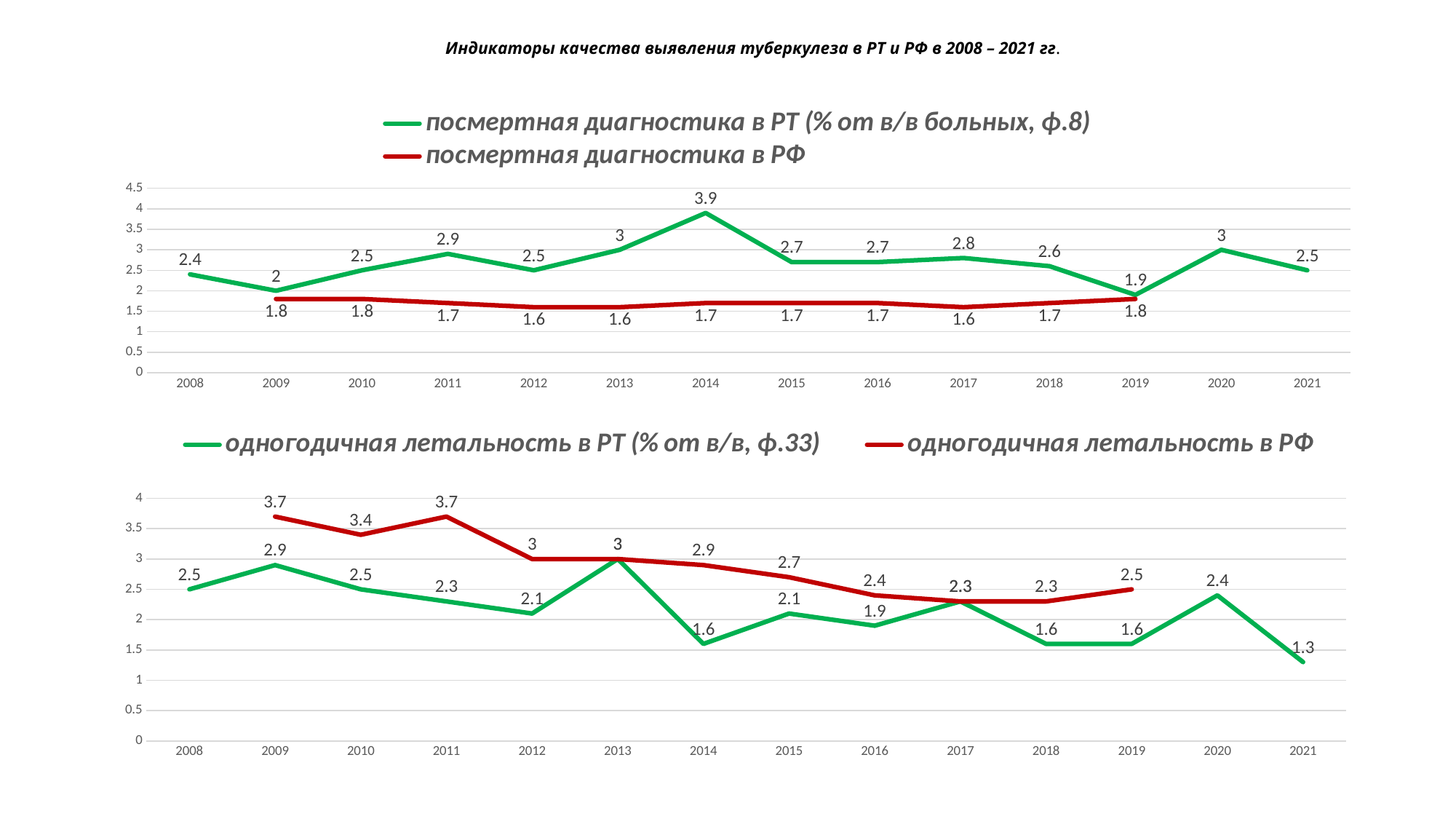
In the bottom chart (одногодичная летальность), which is larger in 2016: the РТ value or the РФ value? РФ In the top chart (посмертная диагностика), what is the value for РФ in 2012? 1.6 In the bottom chart (одногодичная летальность), what is the value for РТ in 2021? 1.3 In the top chart (посмертная диагностика), what is the value for РТ in 2014? 3.9 In the top chart (посмертная диагностика), how many series does the legend list? 2 In the bottom chart (одногодичная летальность), in which year is the РТ series lowest? 2021 What type of chart is the bottom chart (одногодичная летальность)? Line chart In the bottom chart (одногодичная летальность), how many years are shown on the x axis? 14 In the top chart (посмертная диагностика), in which year is the РТ series lowest? 2019 In the top chart (посмертная диагностика), what is the difference between the РТ and РФ values in 2014? 2.2 In the bottom chart (одногодичная летальность), what is the value for РФ in 2010? 3.4 In the top chart (посмертная диагностика), in which year is the РТ series highest? 2014